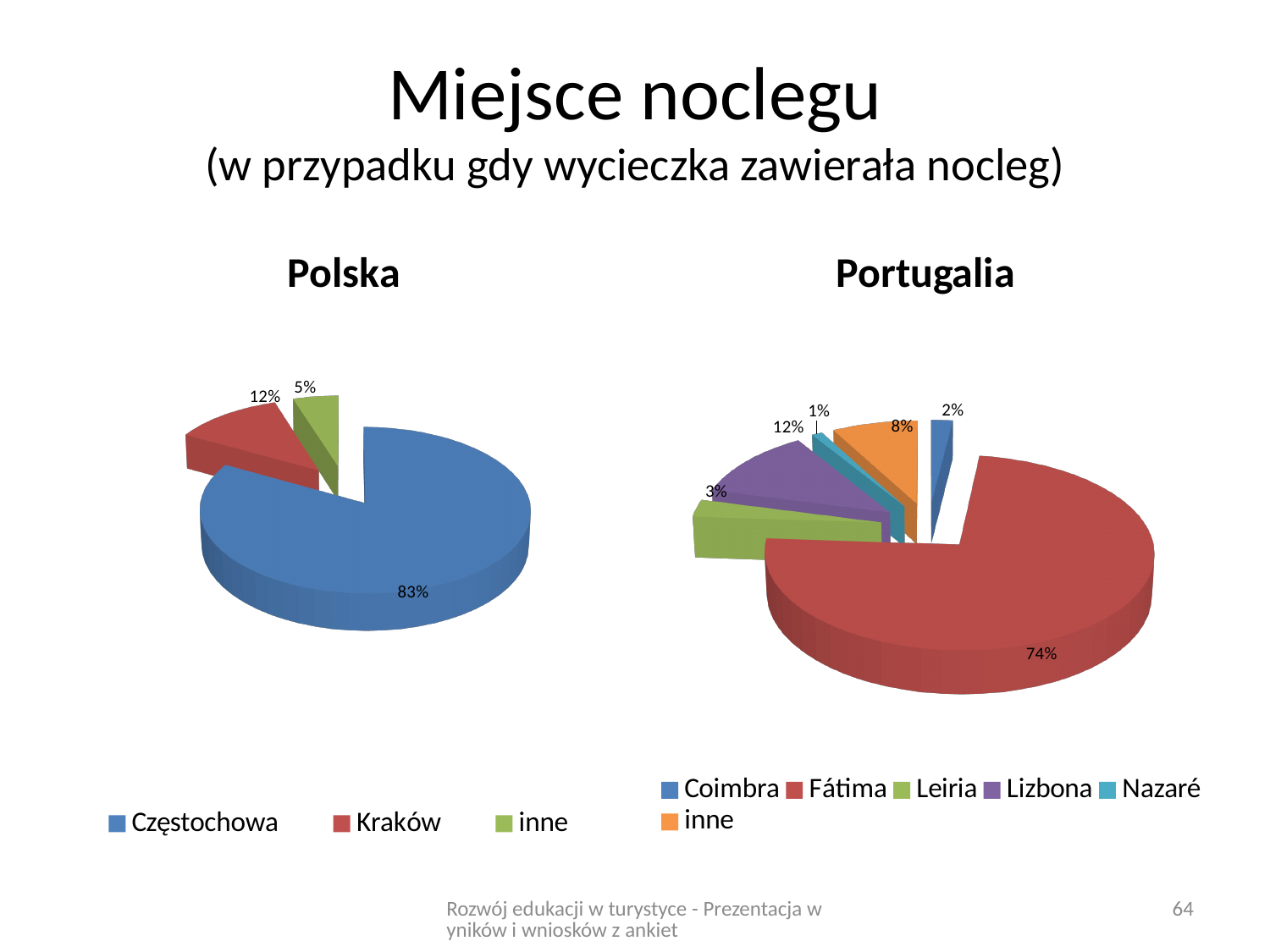
What colour is the Fátima slice in the Portugalia chart? red In the Polska chart, which category has the smallest share? inne What kind of chart is the Polska chart? pie chart How many categories does the Portugalia chart's legend list? 6 In the Portugalia chart, which category has the smallest share? Nazaré In the Polska chart, what is the difference between the shares of Częstochowa and Kraków? 71% In the Portugalia chart, what share does Fátima have? 74% How many categories does the Polska chart's legend list? 3 In the Polska chart, what share does Kraków have? 12% In the Polska chart, what share does Częstochowa have? 83% In the Portugalia chart, which is larger, the share for inne or the share for Coimbra? inne In the Portugalia chart, what share does Lizbona have? 12%